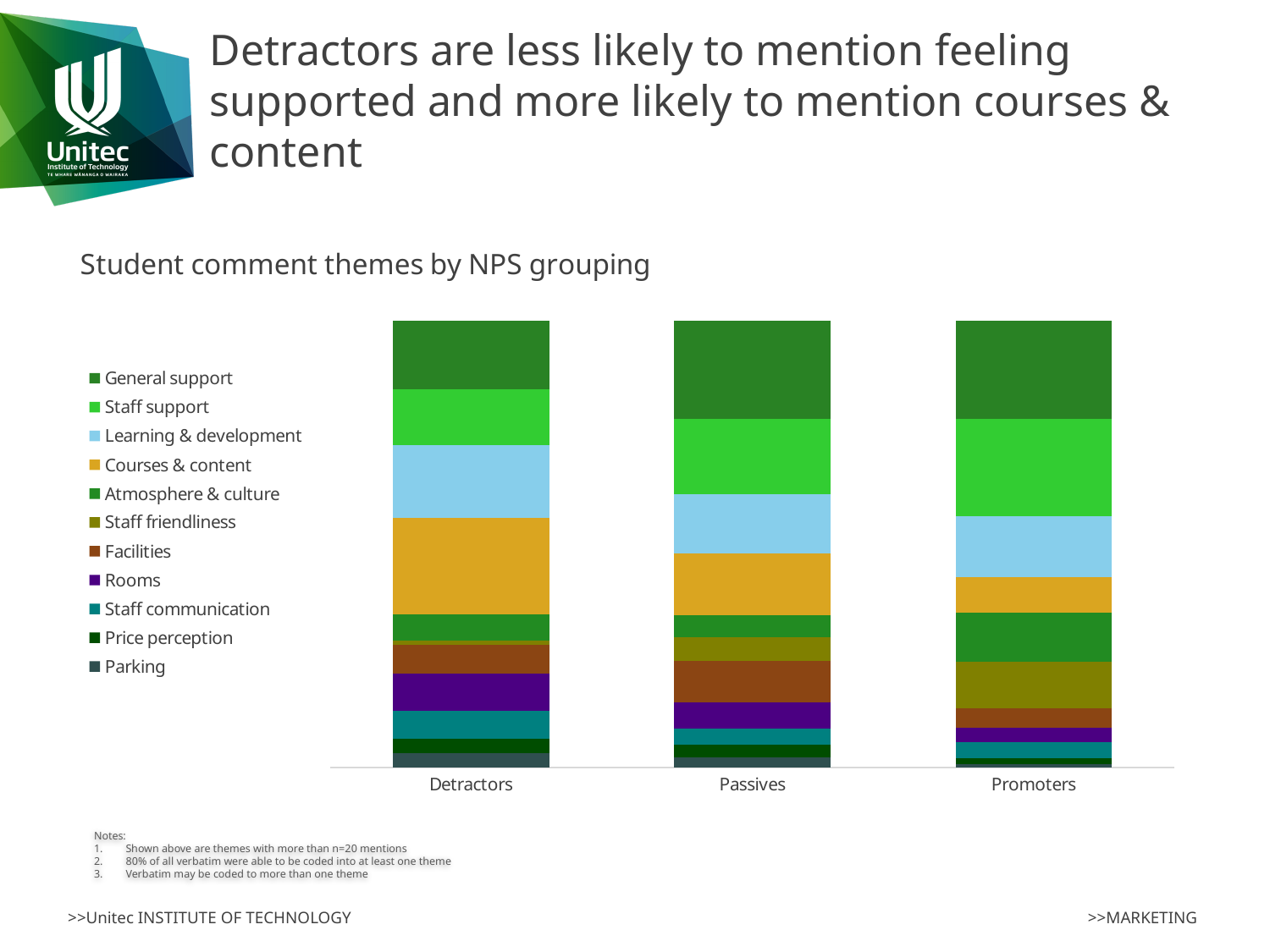
What is the title of the chart? Student comment themes by NPS grouping How many comment themes does the legend list? 11 Which NPS grouping has the smallest General support segment? Detractors How many NPS groupings (categories) are shown along the x axis? 3 Which NPS grouping has the smallest Staff support segment? Detractors Which theme is listed first in the legend? General support Is the Rooms segment larger for Detractors or for Promoters? Detractors Which NPS grouping has the smallest Courses & content segment? Promoters Which NPS grouping has the largest Staff friendliness segment? Promoters What kind of chart is shown on the slide? Stacked bar chart Which NPS grouping has the largest Courses & content segment? Detractors Is the Atmosphere & culture segment larger for Promoters or for Passives? Promoters